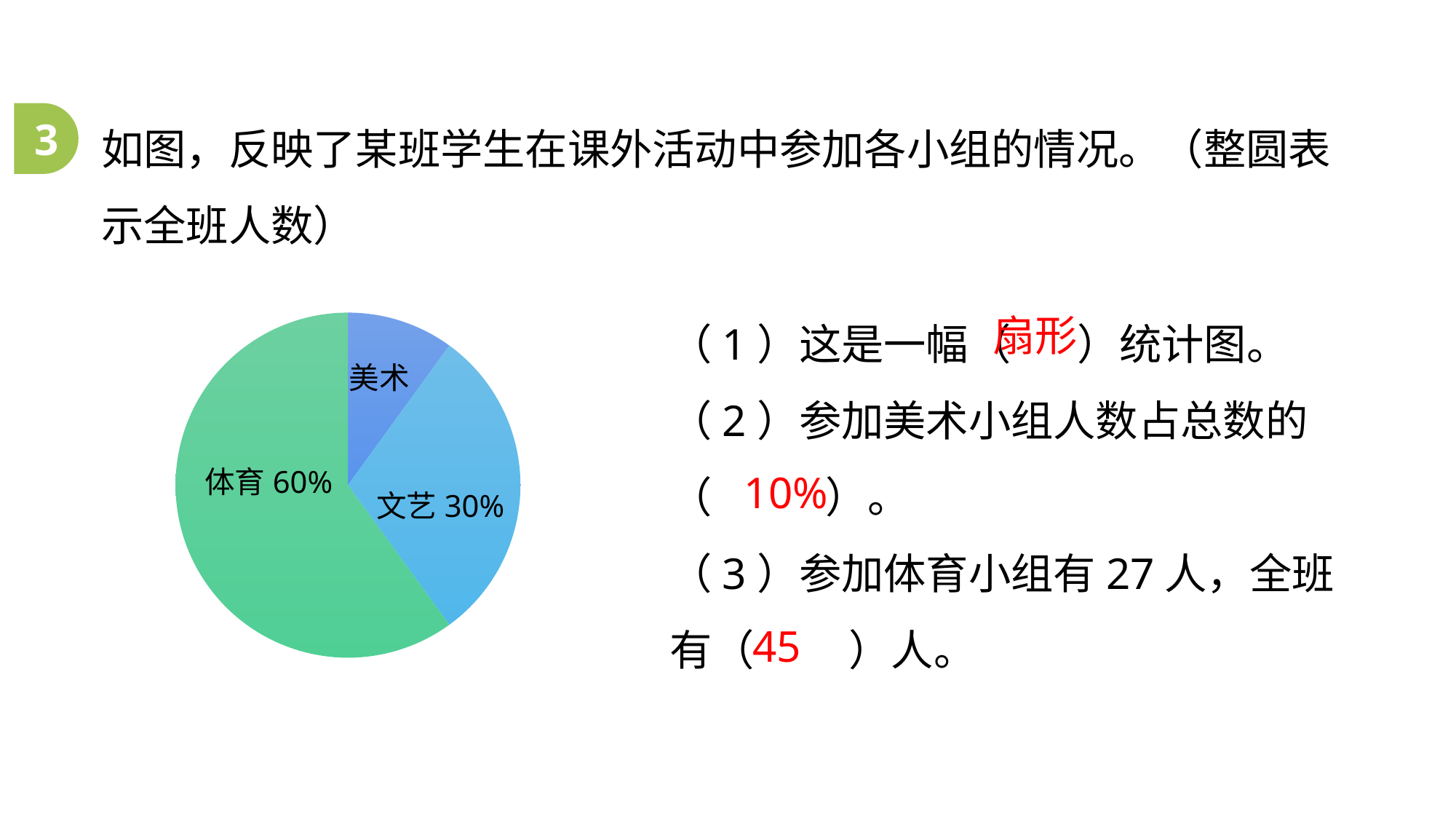
What percentage is shown for 体育 in the pie chart? 60% What percentage is shown for 文艺 in the pie chart? 30% Which slice is larger, 体育 or 文艺? 体育 Which slice is larger, 文艺 or 美术? 文艺 What kind of chart is shown on the slide? pie chart Which group has the smallest slice of the pie chart? 美术 What share of the whole pie does the 美术 slice represent? 10% What is the difference in percentage points between the 体育 and 文艺 slices? 30% What colour is the 体育 slice in the pie chart? green Is the share for 体育 greater or less than 50%? greater How many slices does the pie chart have? 3 Which group has the largest slice of the pie chart? 体育